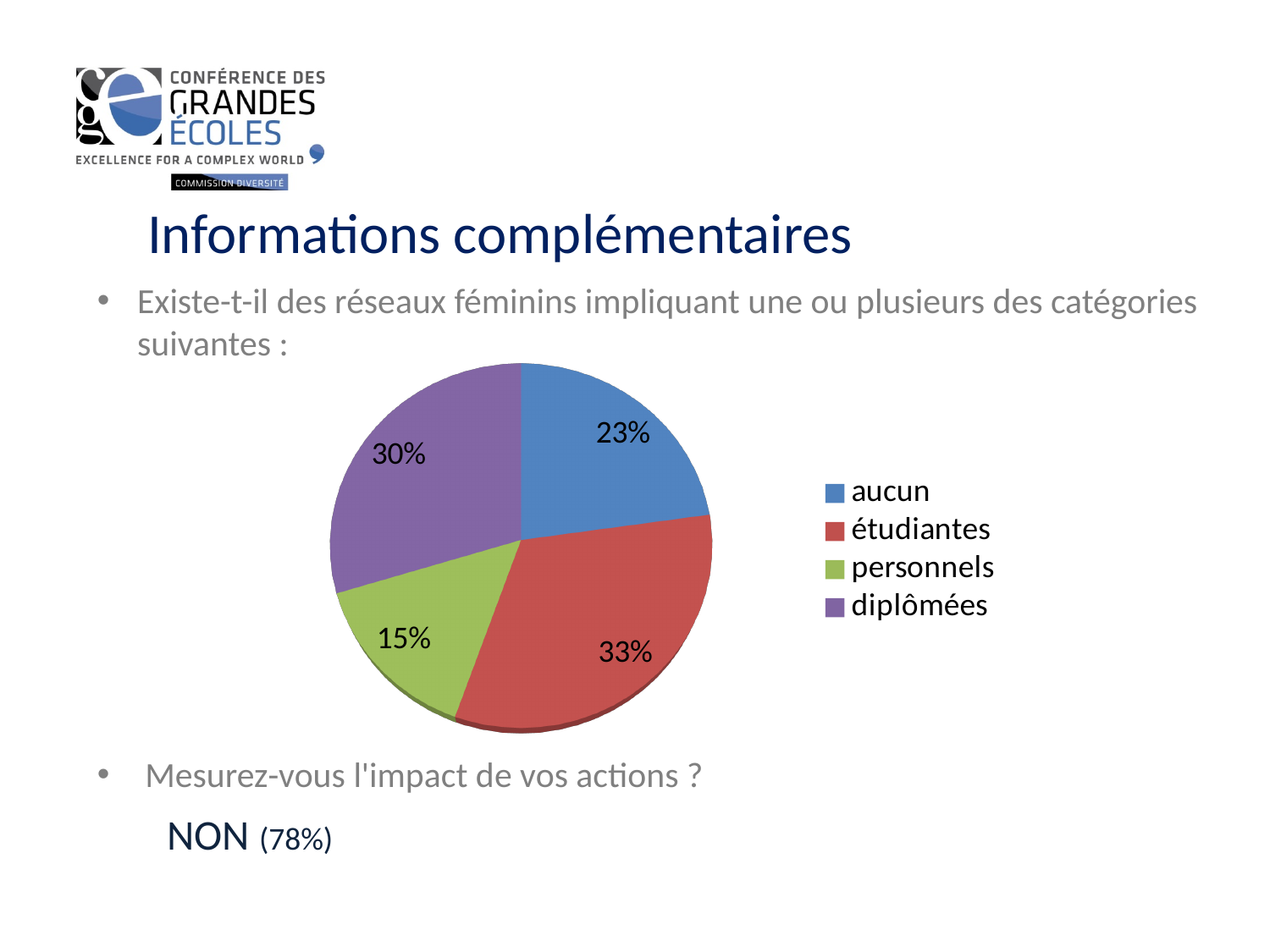
What is the difference in percentage points between the 'étudiantes' slice and the 'personnels' slice? 18 What share of the pie does the 'aucun' slice represent? 23% What colour is the 'diplômées' slice? purple Which slice is larger, 'diplômées' or 'aucun'? diplômées What share of the pie does the 'personnels' slice represent? 15% What kind of chart is shown on the slide? pie chart How many entries does the legend list? 4 How many categories does the pie chart have? 4 Which category has the largest slice of the pie? étudiantes Which category has the smallest slice of the pie? personnels What share of the pie does the 'diplômées' slice represent? 30%